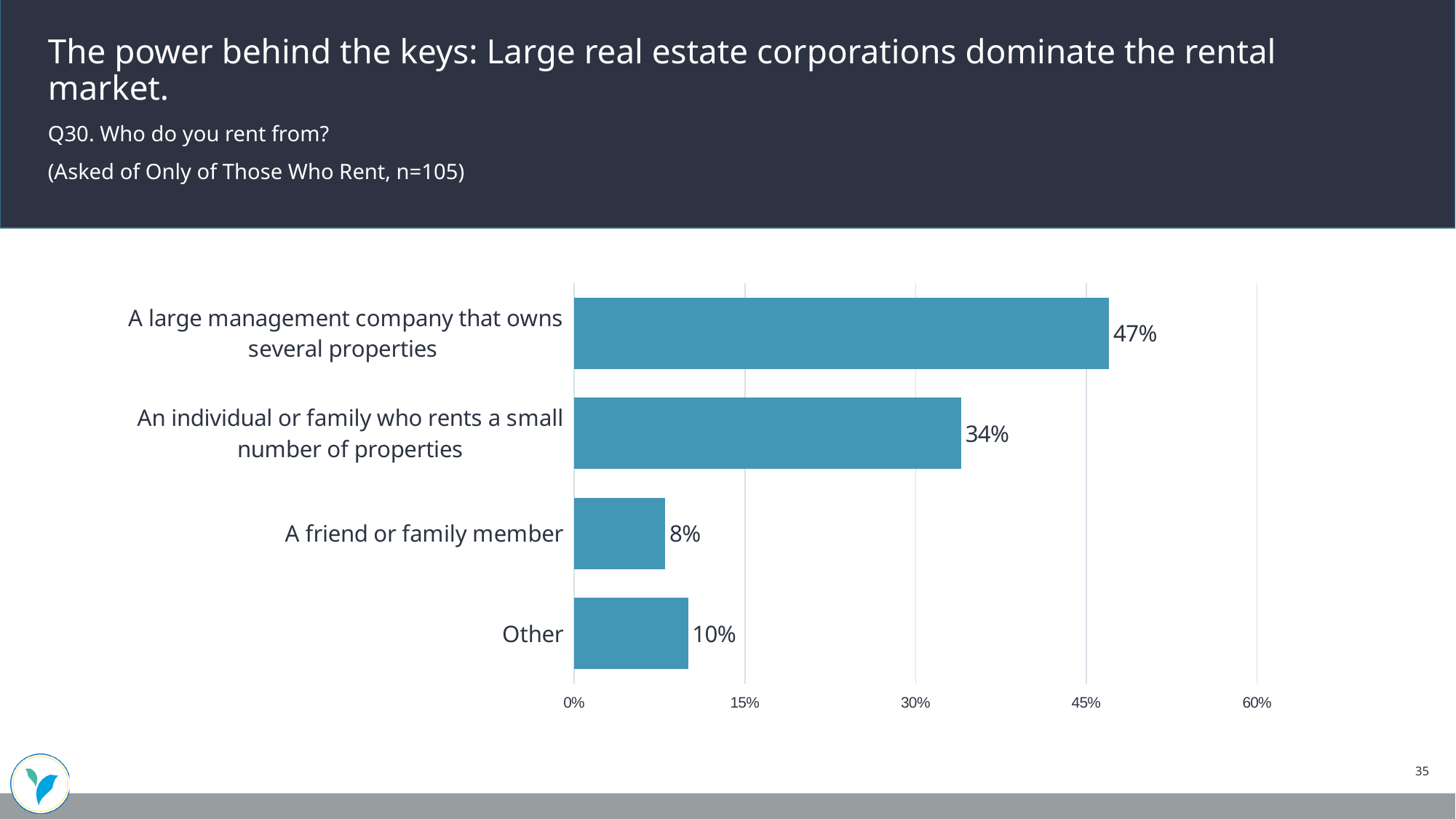
What is the value shown for the 'Other' category? 10% What percentage of renters rent from a friend or family member? 8% Which category has the lowest value? A friend or family member Which is larger: the value for 'Other' or the value for 'A friend or family member'? Other What percentage of renters rent from a large management company that owns several properties? 47% What is the difference between the value for a large management company and the value for an individual or family? 13 percentage points What kind of chart is shown on the slide? Bar chart What percentage of renters rent from an individual or family who rents a small number of properties? 34% What is the sample size noted for this question? n=105 Which category has the highest value? A large management company that owns several properties Is the value for a large management company greater or less than 45%? greater How many categories are shown in the chart? 4